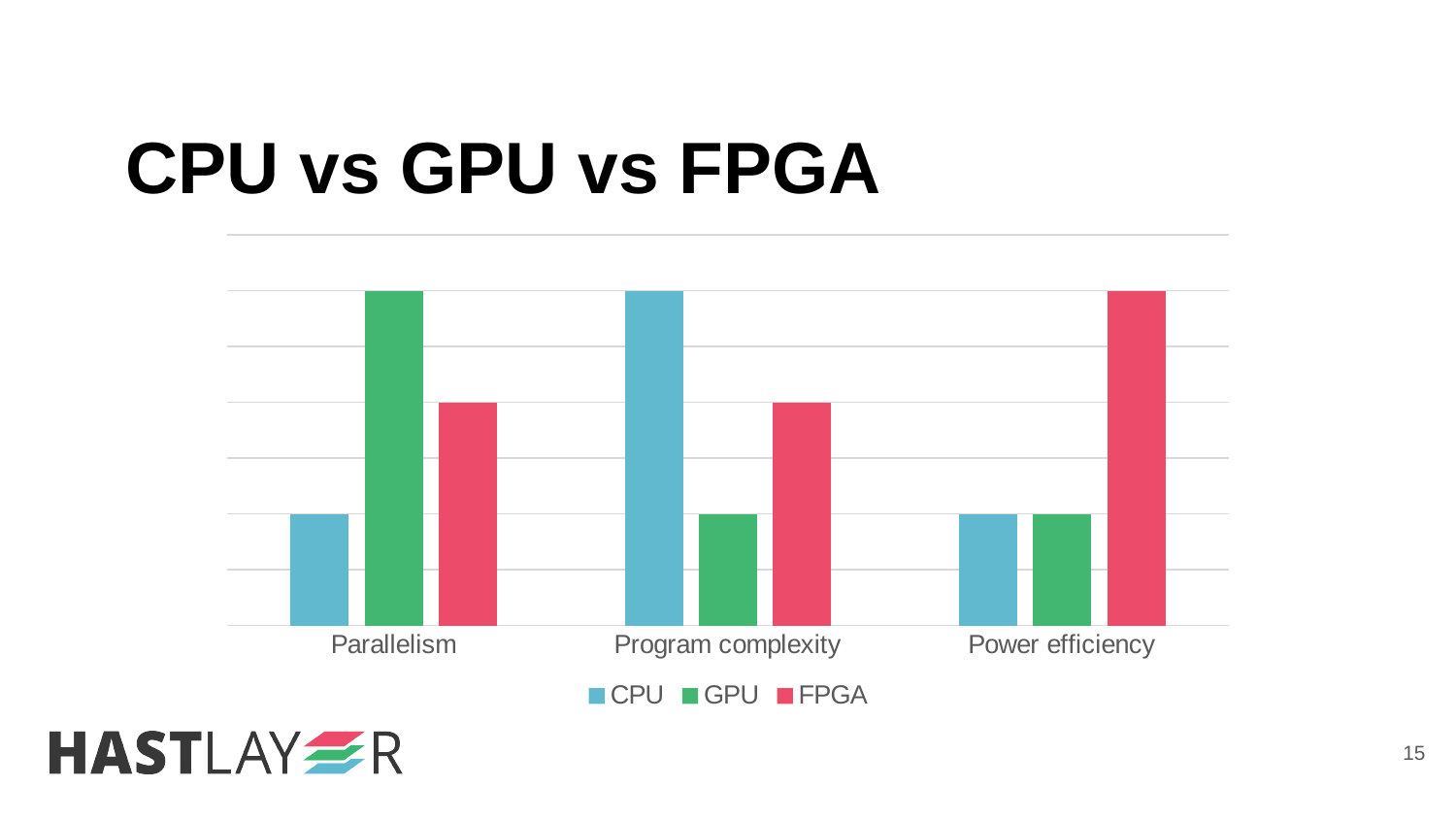
For Parallelism, which is larger: the GPU bar or the FPGA bar? GPU What is the title of the slide containing the chart? CPU vs GPU vs FPGA What are the three series listed in the legend? CPU, GPU, FPGA For Program complexity, which is larger: the CPU bar or the FPGA bar? CPU What kind of chart is shown on the slide? Bar chart Which series has the lowest bar for Program complexity? GPU Which series has the highest bar for Program complexity? CPU How many series does the legend list? 3 Which series has the lowest bar for Parallelism? CPU Which series has the highest bar for Power efficiency? FPGA How many categories are shown on the x axis? 3 Which series has the highest bar for Parallelism? GPU